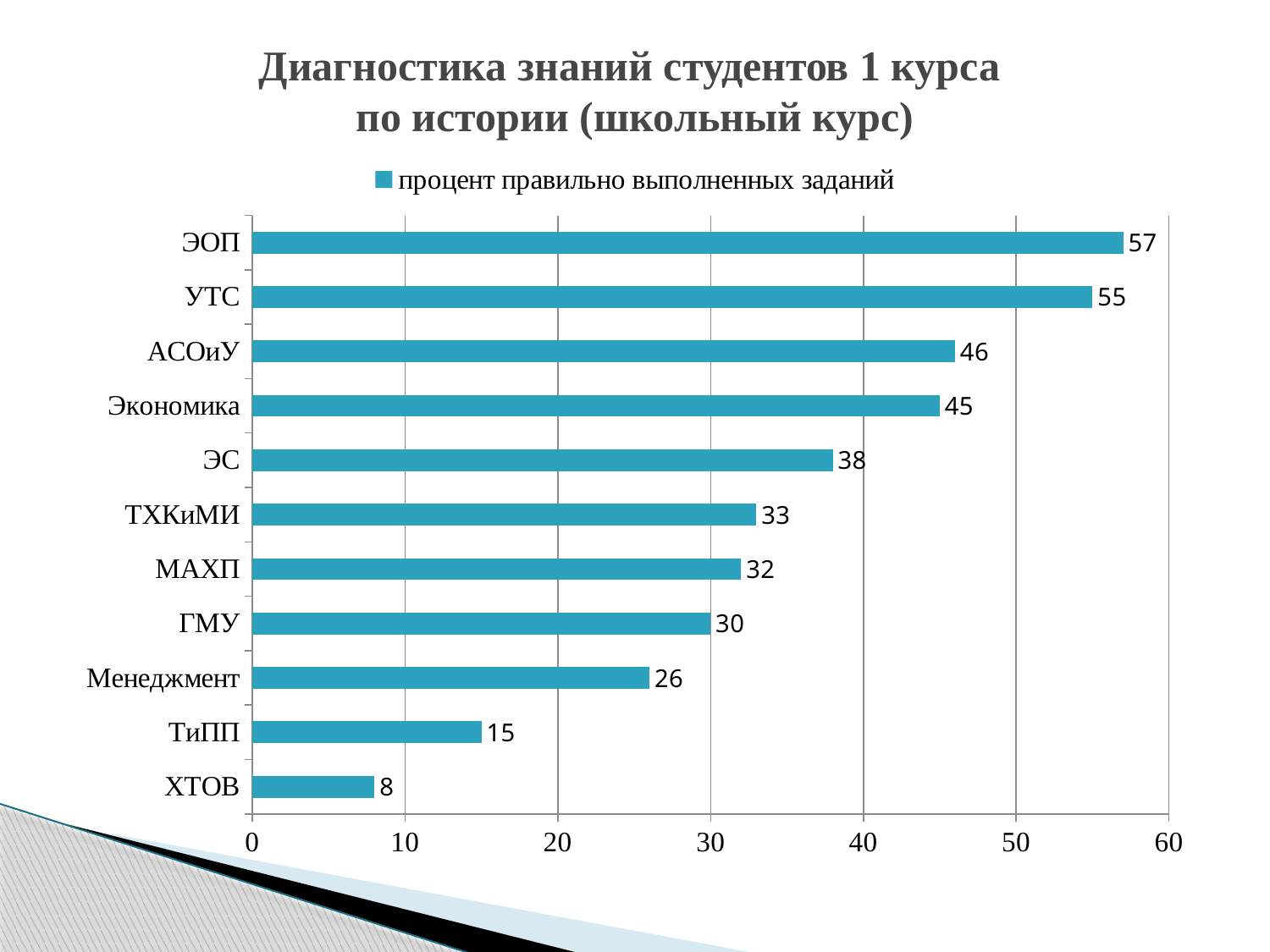
What kind of chart is shown on the slide? bar chart How many categories are shown in the chart? 11 Which is larger, the value for ЭС or the value for ГМУ? ЭС Which category has the lowest value? ХТОВ What is the difference between the values for УТС and Экономика? 10 What is the value for Менеджмент? 26 Is the value for АСОиУ greater or less than 40? greater What is the value for ЭОП? 57 What is the value for ТиПП? 15 How many series does the legend list? 1 What is the legend entry of the chart? процент правильно выполненных заданий Which category has the highest value? ЭОП